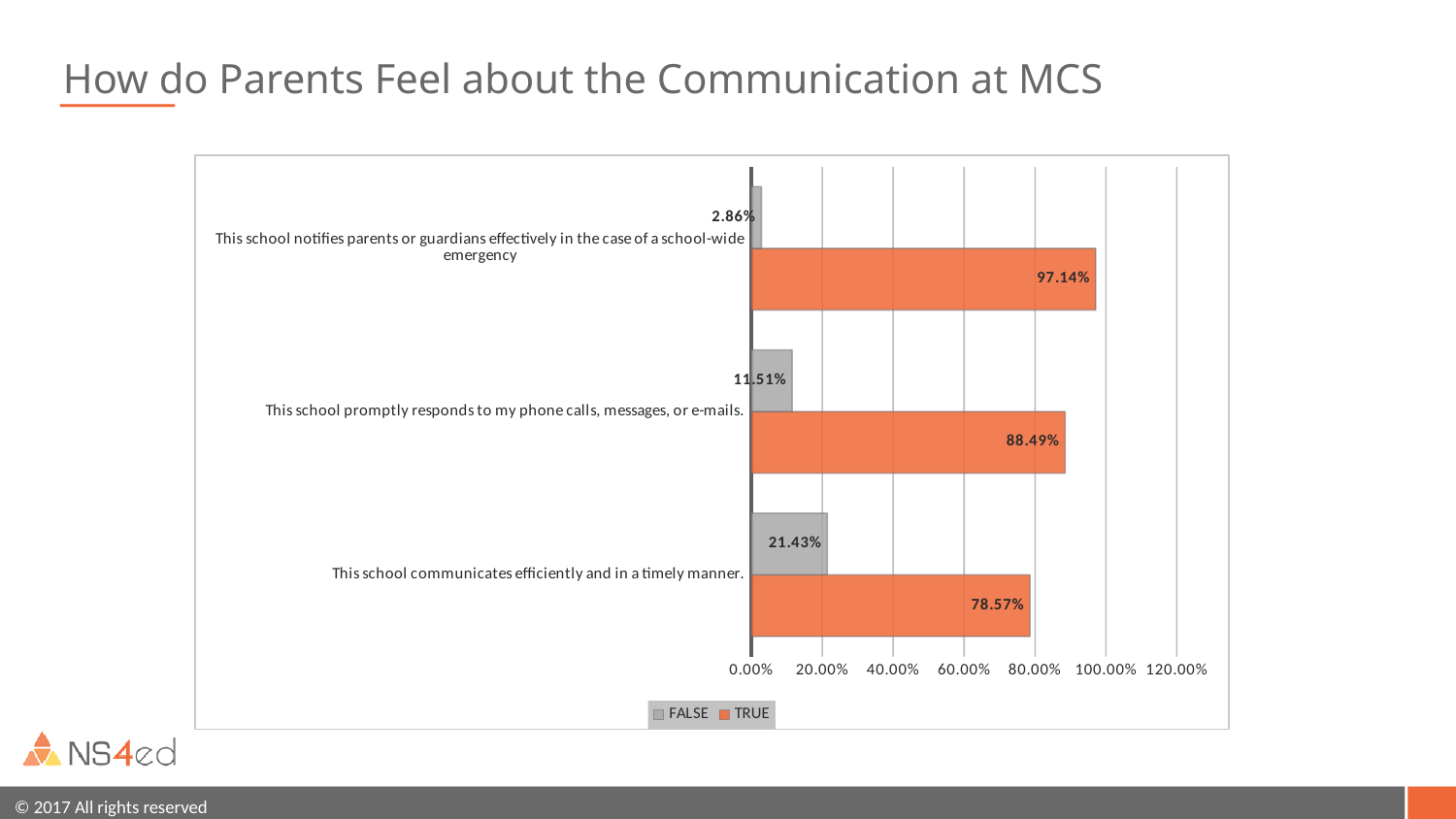
Which statement has the highest TRUE value? This school notifies parents or guardians effectively in the case of a school-wide emergency What is the difference between the TRUE and FALSE values for "This school communicates efficiently and in a timely manner."? 57.14% How many series does the legend list? 2 What kind of chart is shown on the slide? Bar chart Is the TRUE value for "This school promptly responds to my phone calls, messages, or e-mails." greater or less than 80.00%? greater Which colour represents the TRUE series in the chart? Orange What is the FALSE value for "This school communicates efficiently and in a timely manner."? 21.43% What is the FALSE value for "This school promptly responds to my phone calls, messages, or e-mails."? 11.51% How many statements (categories) are shown in the chart? 3 Which statement has the lowest FALSE value? This school notifies parents or guardians effectively in the case of a school-wide emergency Which is larger: the TRUE value for "This school promptly responds to my phone calls, messages, or e-mails." or the TRUE value for "This school communicates efficiently and in a timely manner."? This school promptly responds to my phone calls, messages, or e-mails. What is the TRUE value for "This school notifies parents or guardians effectively in the case of a school-wide emergency"? 97.14%